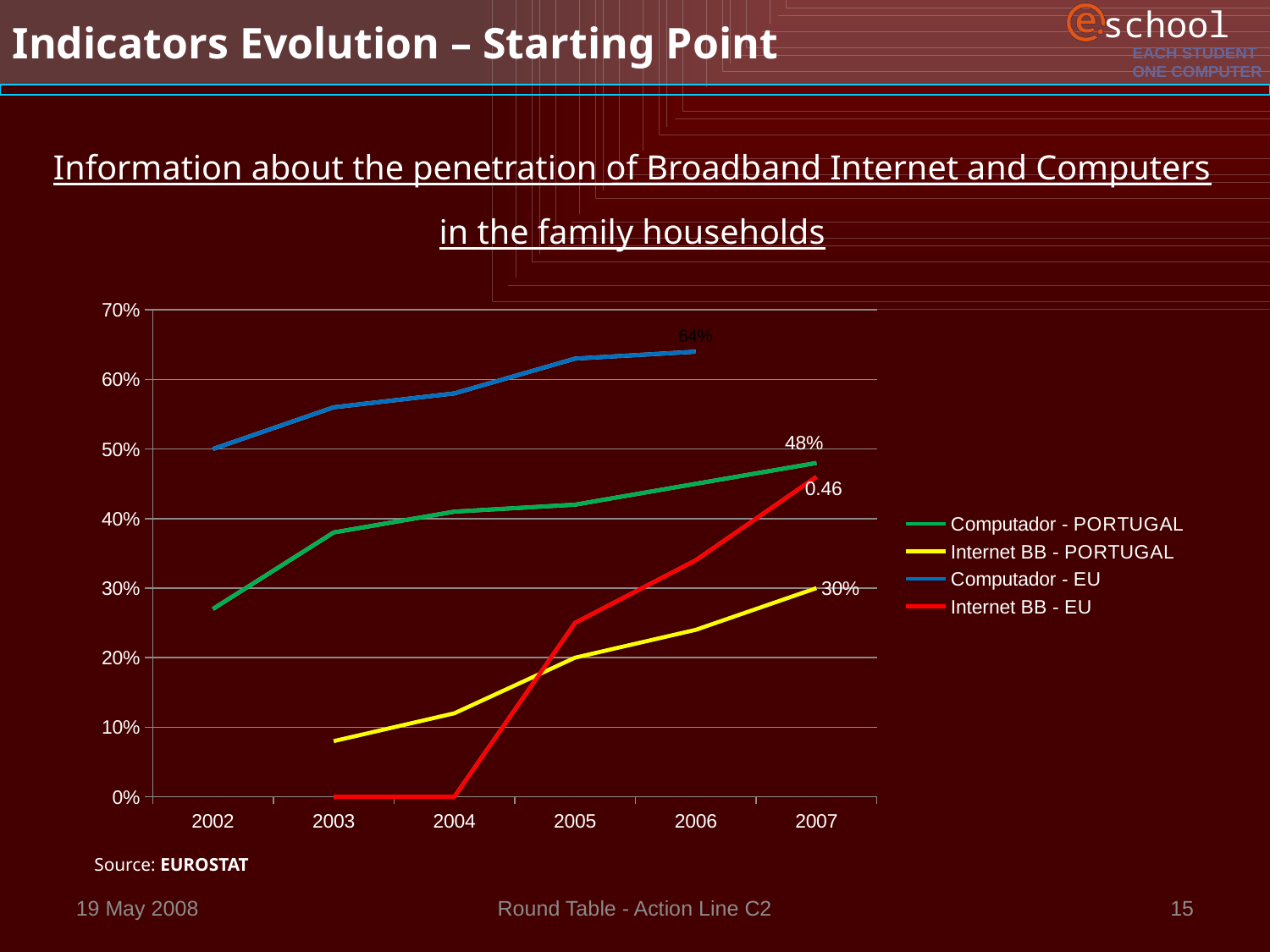
What data label is shown for Internet BB - EU in 2007? 0.46 What source is cited below the chart? EUROSTAT Does the Computador - PORTUGAL line rise or fall from 2002 to 2007? rise What kind of chart is shown on the slide? line chart What is the value for Computador - PORTUGAL in 2007? 48% What is the value for Computador - EU in 2006? 64% Which series has the highest value in 2006? Computador - EU What is the difference between Computador - PORTUGAL and Internet BB - PORTUGAL in 2007? 18% How many years are shown on the x axis? 6 How many series does the legend list? 4 Is the value for Internet BB - EU in 2004 greater or less than 10%? less What is the value for Internet BB - PORTUGAL in 2007? 30%